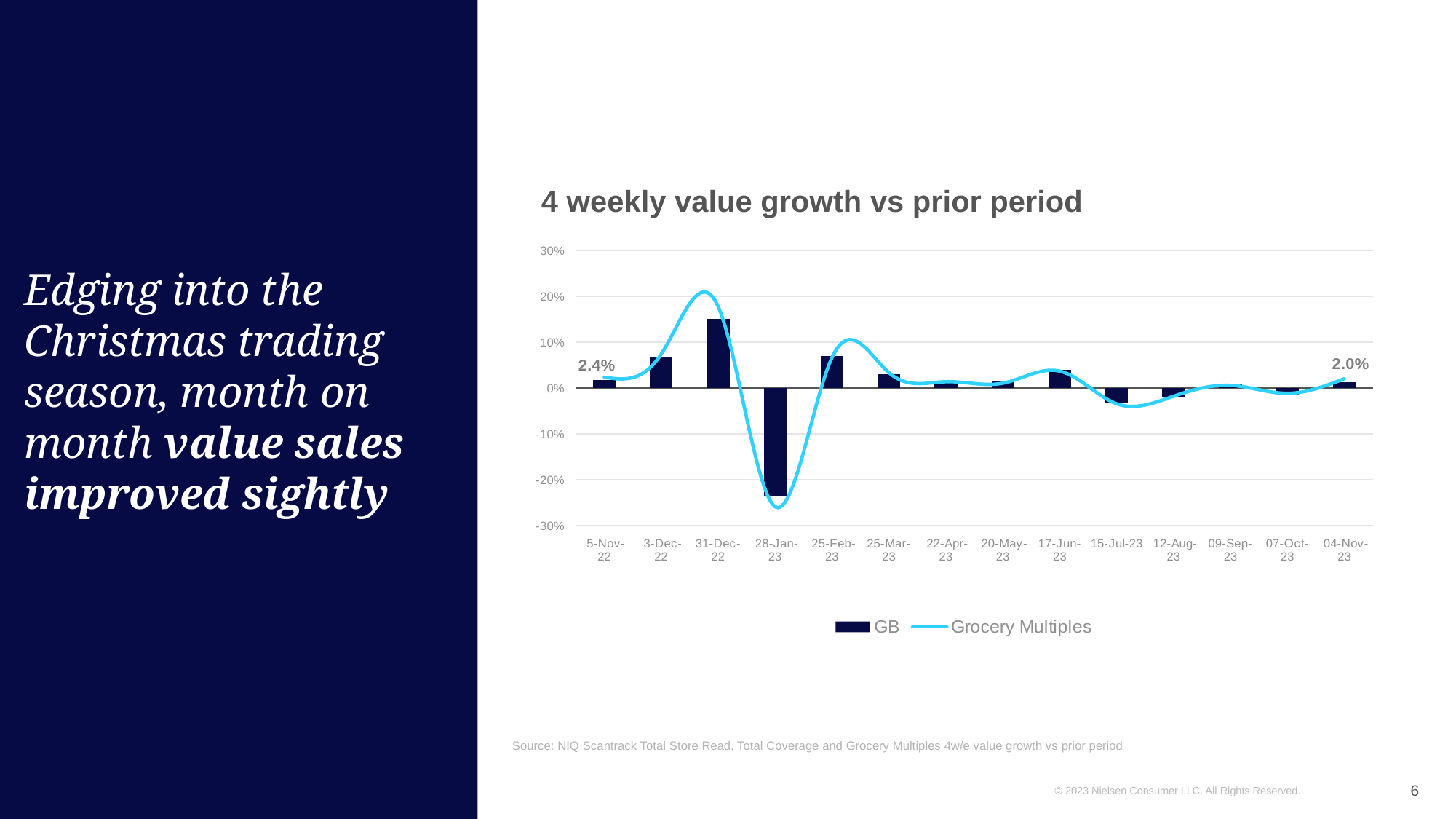
What data label is shown at 5-Nov-22? 2.4% Which two series are listed in the legend? GB and Grocery Multiples What kind of chart is this? Combined bar and line chart What data label is shown at 04-Nov-23? 2.0% How many series does the legend list? 2 How many dates are shown on the x axis? 14 At which date is the GB bar highest? 31-Dec-22 At which date is the GB bar lowest? 28-Jan-23 What is the title of the chart? 4 weekly value growth vs prior period Is the GB value for 28-Jan-23 greater or less than -20%? less Which has the larger GB value, 3-Dec-22 or 31-Dec-22? 31-Dec-22 Is the GB value for 31-Dec-22 greater or less than 10%? greater